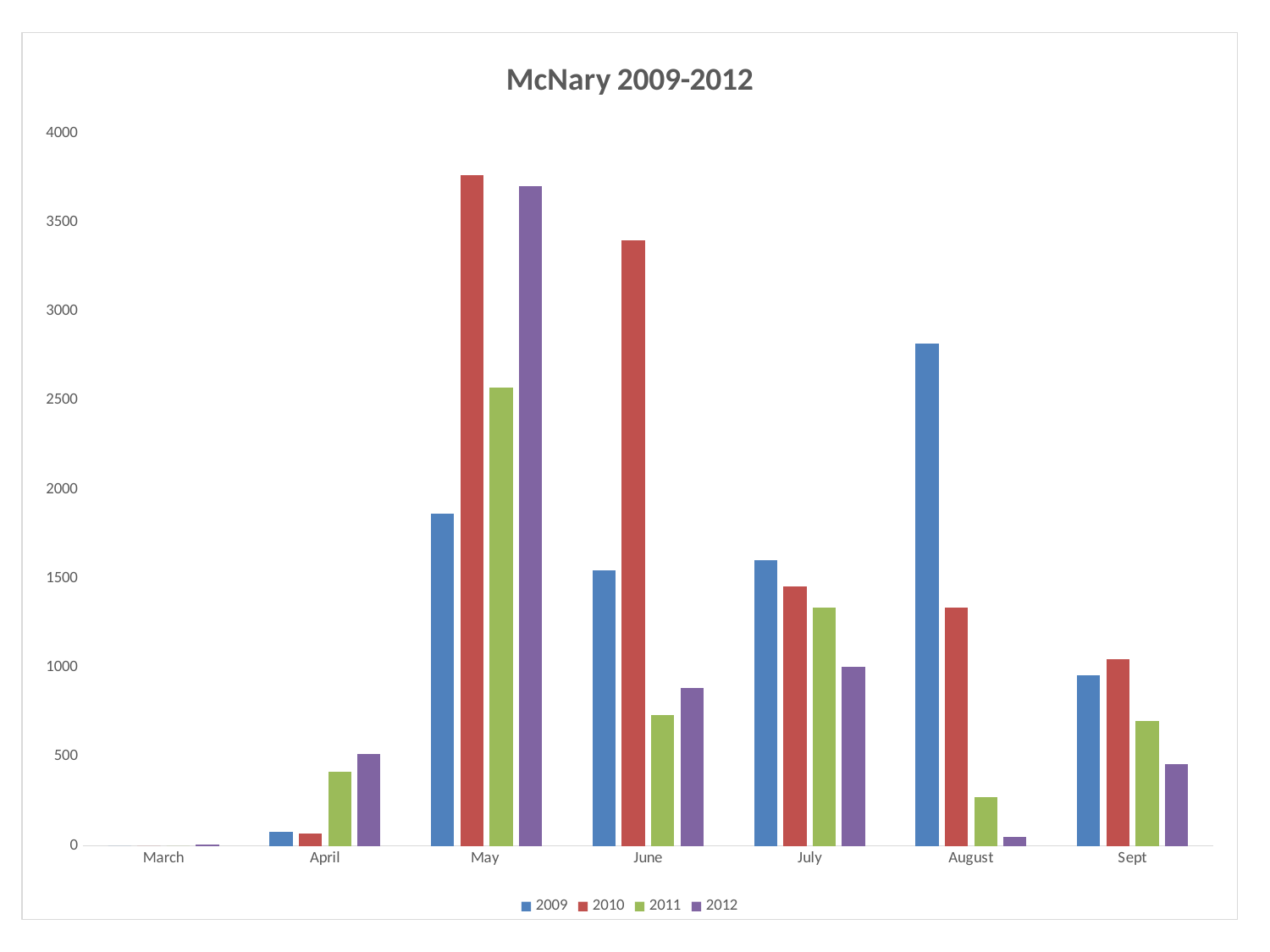
Is the 2010 value for June greater or less than 3000? greater How many months are shown on the x axis? 7 In August, which series has the lowest value? 2012 Do the 2010 values rise or fall from May through Sept? fall In which month is the 2009 value highest? August In May, which is larger: the 2010 value or the 2011 value? 2010 In which month is the 2010 value highest? May Is the 2011 value for April greater or less than 500? less What kind of chart is shown on the slide? bar chart What is the title of the chart? McNary 2009-2012 How many series does the legend list? 4 Is the 2009 value for May greater or less than 2000? less